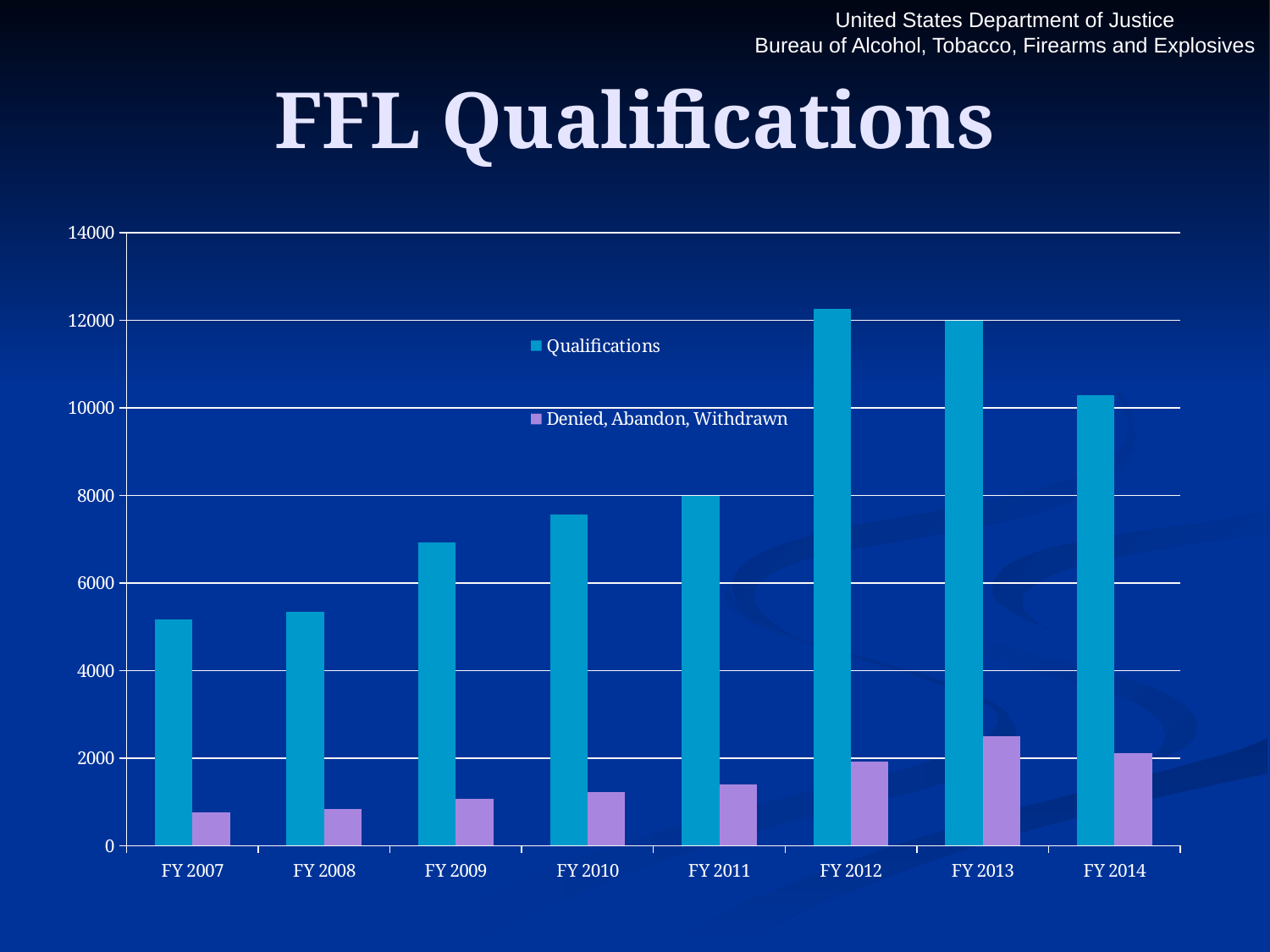
Do the Qualifications values rise or fall from FY 2007 to FY 2012? rise How many series does the legend list? 2 Which fiscal year has the highest Denied, Abandon, Withdrawn value? FY 2013 Which fiscal year has the highest Qualifications value? FY 2012 Which is larger, the Qualifications value for FY 2012 or for FY 2014? FY 2012 Is the Qualifications value for FY 2009 greater or less than 6000? greater Is the Qualifications value for FY 2014 greater or less than 10000? greater Is the Denied, Abandon, Withdrawn value for FY 2007 greater or less than 1000? less How many fiscal years are shown on the x axis? 8 What kind of chart is shown on the slide? bar chart